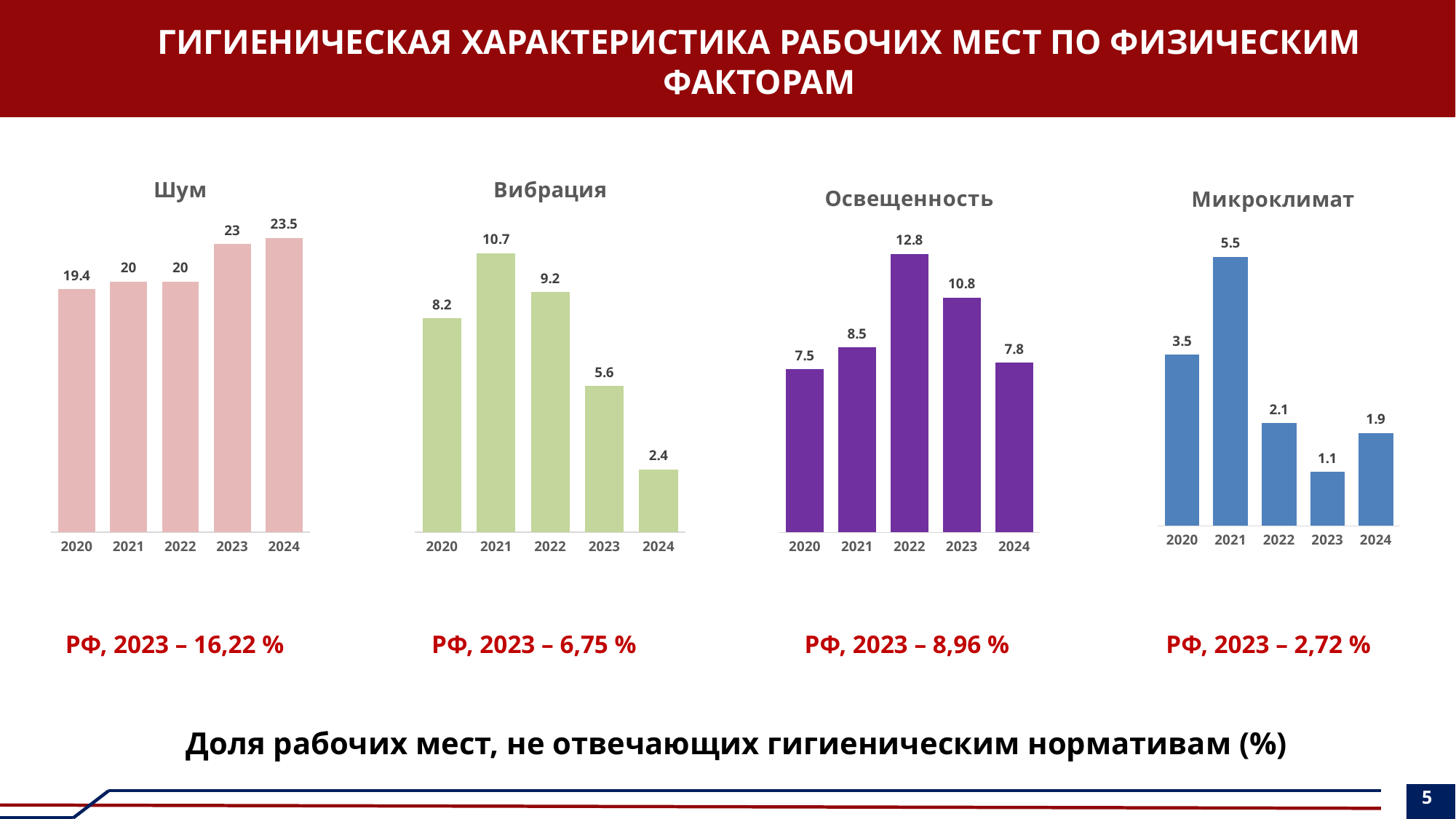
In the "Шум" chart, what is the value for 2024? 23.5 What colour are the bars in the "Вибрация" chart? light green In the "Вибрация" chart, what is the difference between the 2021 and 2023 values? 5.1 In the "Освещенность" chart, which year has the lowest value? 2020 In the "Шум" chart, do the values generally rise or fall from 2020 to 2024? rise What type of chart is the "Освещенность" chart? bar chart In the "Освещенность" chart, what is the difference between the 2022 and 2024 values? 5 How many bars are in the "Микроклимат" chart? 5 In the "Вибрация" chart, what is the value for 2024? 2.4 In the "Микроклимат" chart, what is the value for 2021? 5.5 In the "Микроклимат" chart, which is larger, the value for 2022 or the value for 2024? 2022 In the "Вибрация" chart, which year has the highest value? 2021